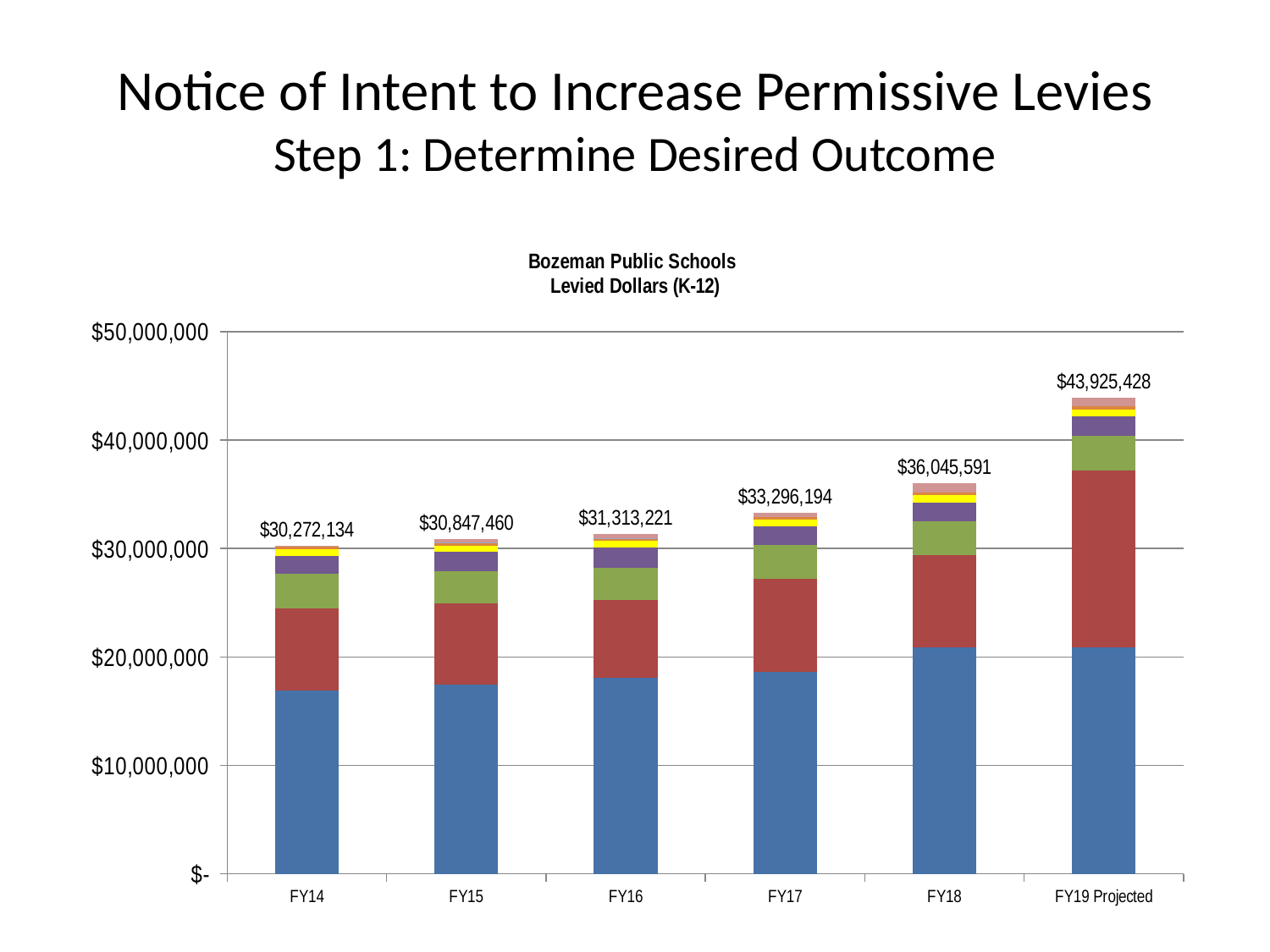
Do the total levied dollars rise or fall from FY14 to FY19 Projected? Rise What is the total levied dollars shown for FY14? $30,272,134 What is the difference between the total for FY15 and the total for FY14? $575,326 What is the difference between the total for FY19 Projected and the total for FY18? $7,879,837 Which fiscal year has the highest total levied dollars? FY19 Projected Which is larger, the total for FY16 or the total for FY17? FY17 How many fiscal years are shown on the x axis? 6 Is the bottom (blue) segment of the FY14 bar greater or less than $20,000,000? less What kind of chart is shown on the slide? Stacked bar chart What is the total levied dollars shown for FY19 Projected? $43,925,428 What is the total levied dollars shown for FY17? $33,296,194 Which fiscal year has the lowest total levied dollars? FY14